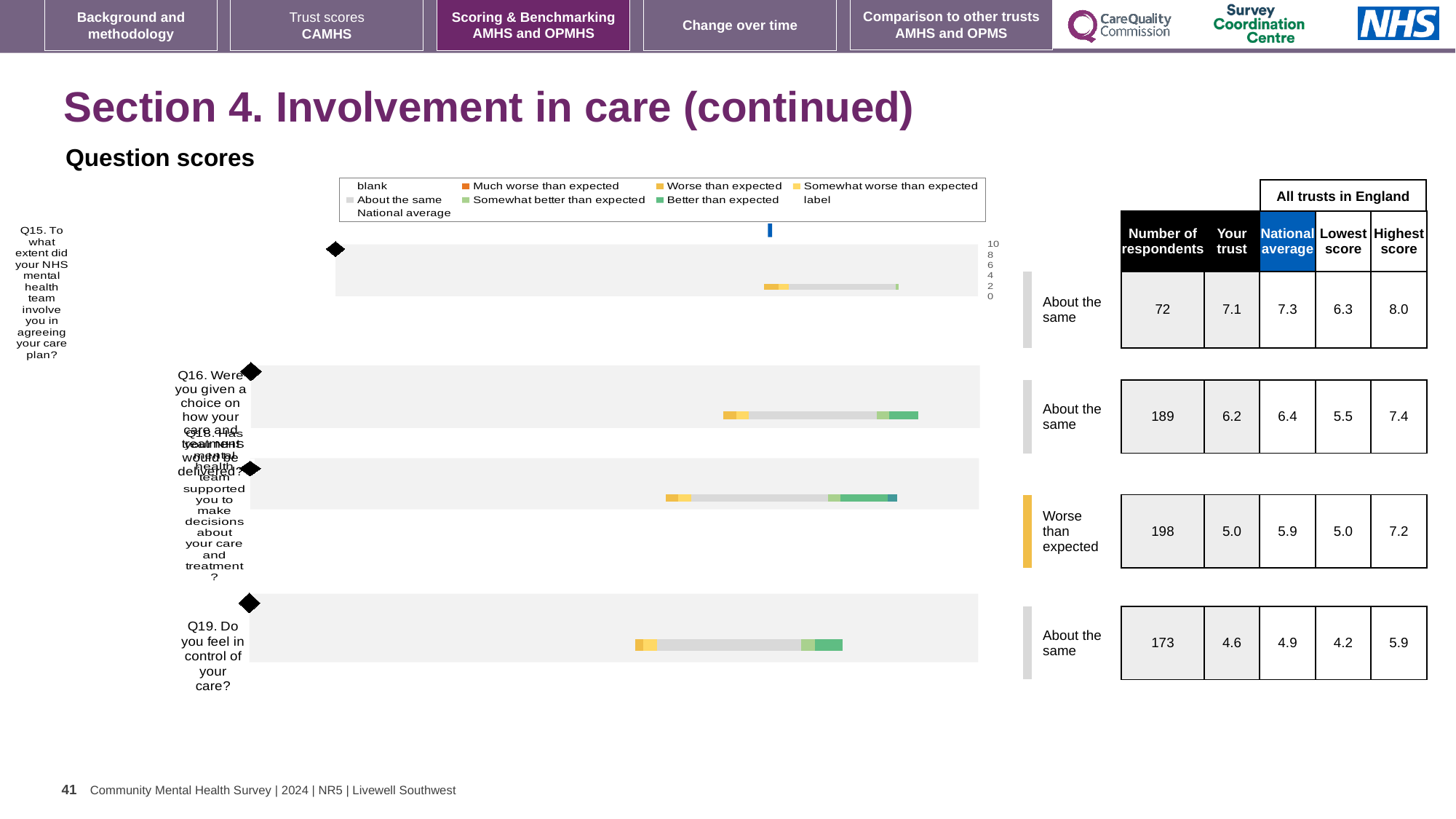
For Q15, what is the difference between the highest score and the lowest score across all trusts in England? 1.7 How many respondents answered Q16 (given a choice on how your care and treatment would be delivered)? 189 Which question has the lowest 'Your trust' score? Q19 What is the highest score across all trusts in England for Q19 (feeling in control of your care)? 5.9 What is the national average score for Q18 (supporting you to make decisions about your care and treatment)? 5.9 Which benchmark category is Q18 placed in? Worse than expected For Q16, which is larger: the 'Your trust' score or the national average? National average What is the 'Your trust' score for Q15 (involving you in agreeing your care plan)? 7.1 What is the heading shown above the question scores chart? Question scores How many survey questions are plotted in the question scores chart? 4 Which question has the highest 'Your trust' score? Q15 What kind of chart is used to show the question scores on this slide? bar chart